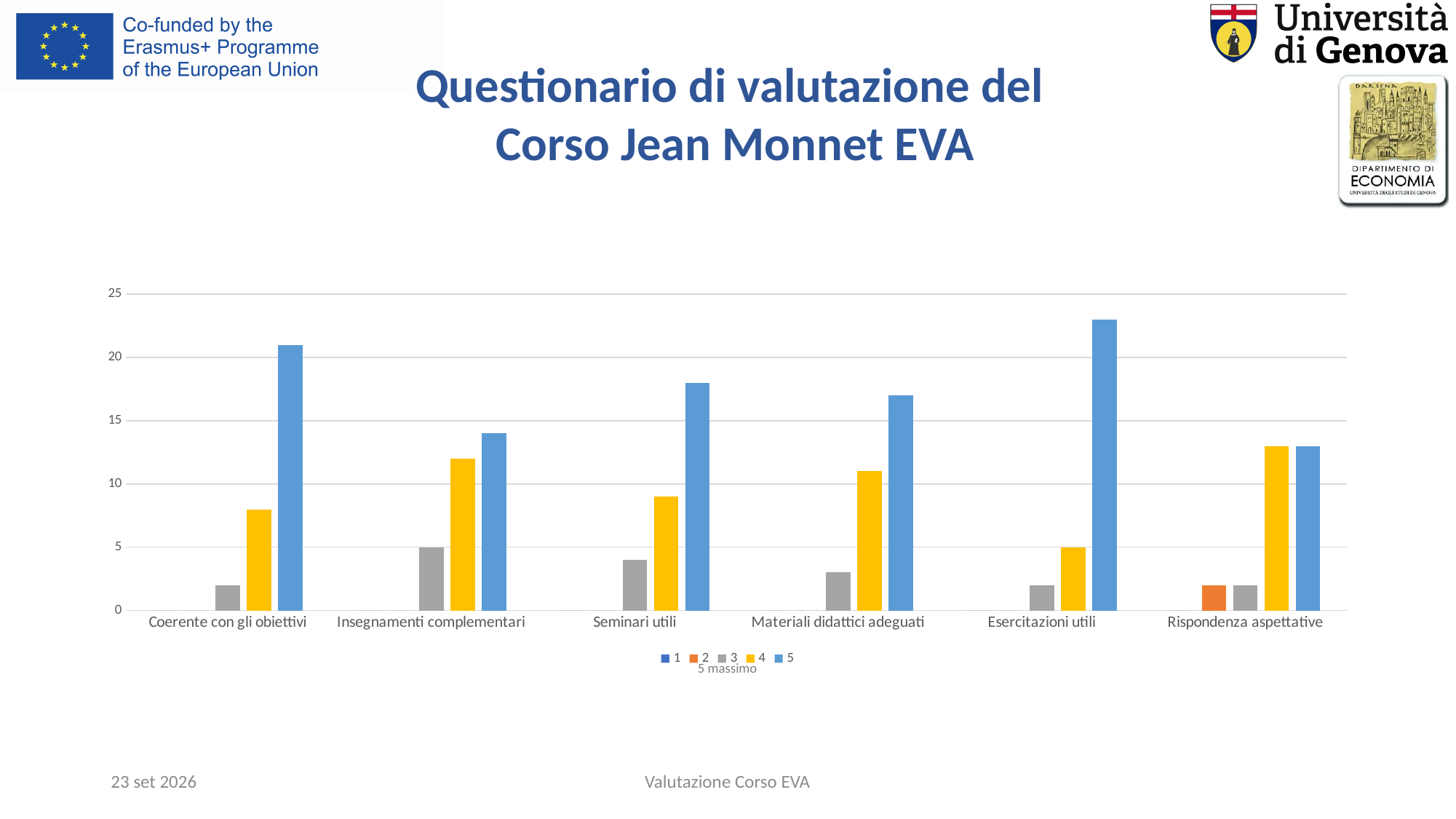
For which category is the bar for series 5 the highest? Esercitazioni utili Which is larger: the series 5 value for Coerente con gli obiettivi or the series 5 value for Seminari utili? Coerente con gli obiettivi Which is larger: the series 4 value for Insegnamenti complementari or the series 4 value for Coerente con gli obiettivi? Insegnamenti complementari What is the value of series 3 for Insegnamenti complementari? 5 How many series does the chart legend list? 5 How many categories are shown on the x axis of the chart? 6 Which category is the only one with a visible bar for series 2? Rispondenza aspettative Is the value of series 5 for Seminari utili greater or less than 15? greater Is the value of series 5 for Coerente con gli obiettivi greater or less than 20? greater What is the value of series 4 for Esercitazioni utili? 5 Is the value of series 3 for Coerente con gli obiettivi greater or less than 5? less What kind of chart is shown on the slide? bar chart